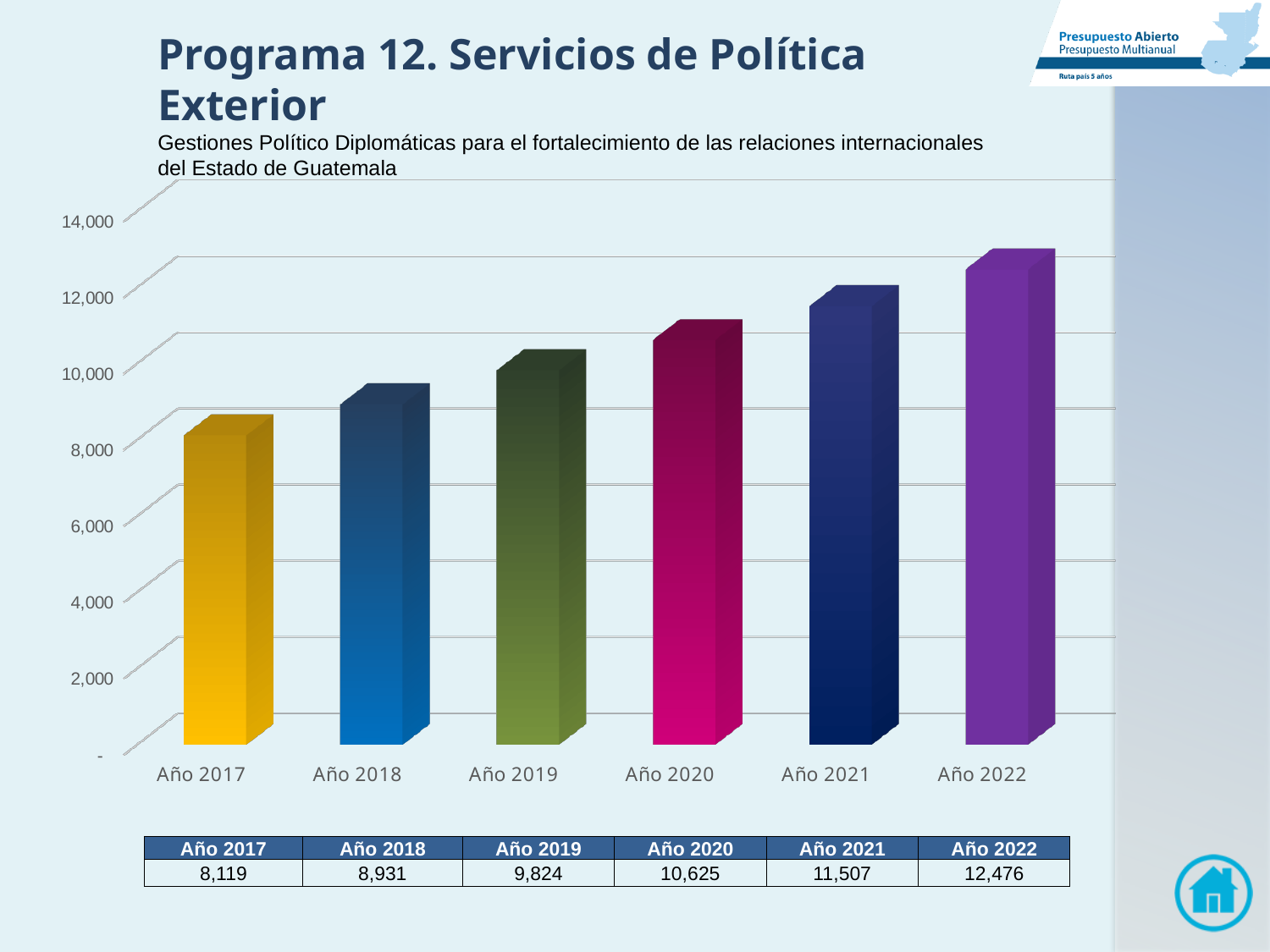
How many years are shown on the x axis? 6 Do the values rise or fall from Año 2017 to Año 2022? rise Is the value for Año 2021 greater or less than 12,000? less Which is larger, the value for Año 2019 or the value for Año 2018? Año 2019 Which year has the highest value? Año 2022 What is the difference between the values for Año 2022 and Año 2017? 4,357 What is the value for Año 2020? 10,625 Which year has the lowest value? Año 2017 What is the value for Año 2017? 8,119 What is the value for Año 2022? 12,476 What kind of chart is shown on the slide? bar chart What is the difference between the values for Año 2021 and Año 2020? 882